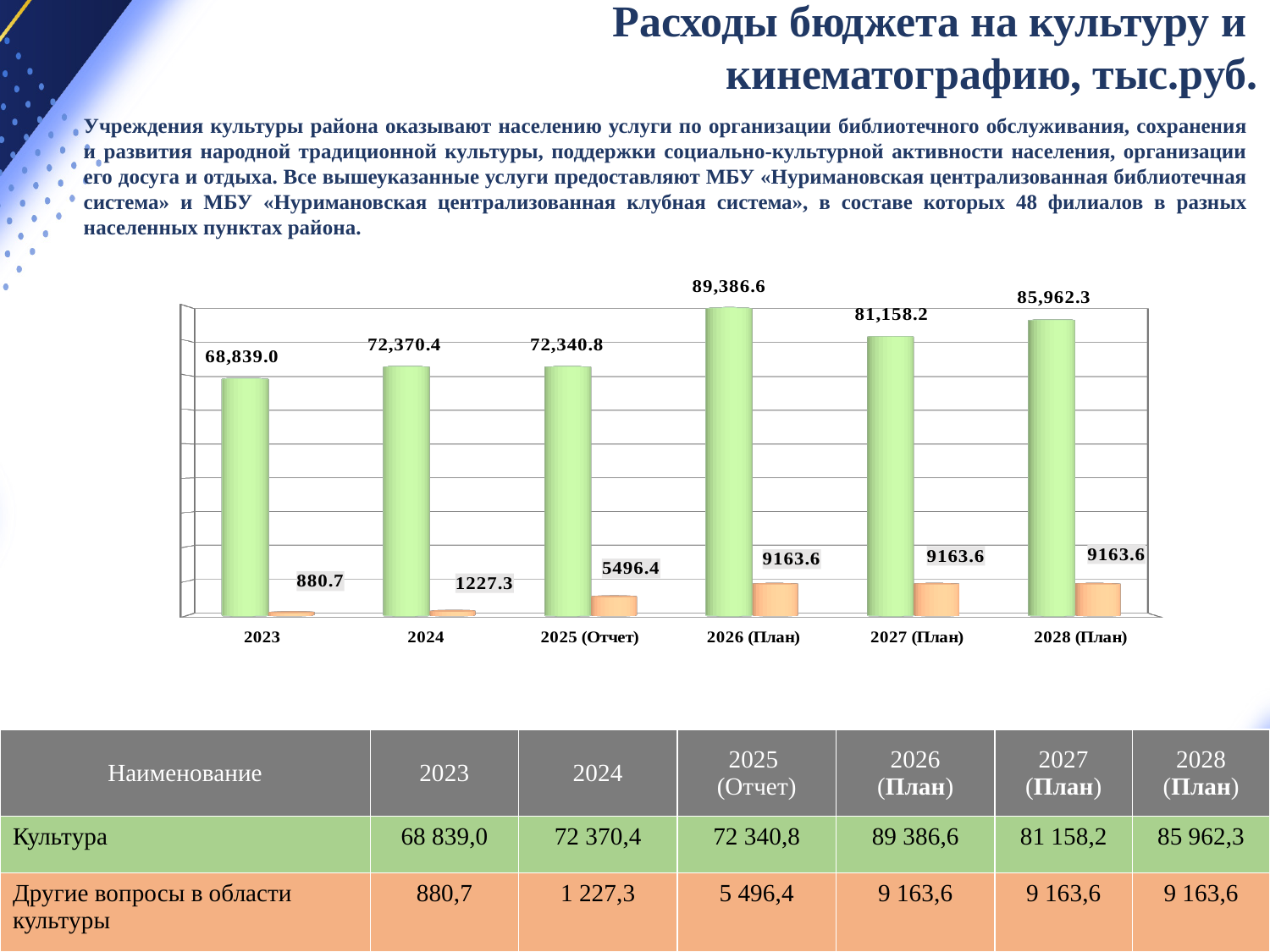
What is the value of the orange bar for 2024? 1227.3 Which green bar is larger, 2026 (План) or 2028 (План)? 2026 (План) What is the value of the green bar for 2023? 68,839.0 What is the value of the green bar for 2026 (План)? 89,386.6 What is the value of the orange bar for 2025 (Отчет)? 5496.4 How many categories are shown on the x axis of the chart? 6 In which category is the green bar highest? 2026 (План) What is the difference between the green bar values for 2026 (План) and 2027 (План)? 8,228.4 In which category is the orange bar lowest? 2023 What is the difference between the orange bar values for 2026 (План) and 2025 (Отчет)? 3667.2 Do the orange bar values rise or fall from 2023 to 2026 (План)? Rise What kind of chart is shown on the slide? Bar chart